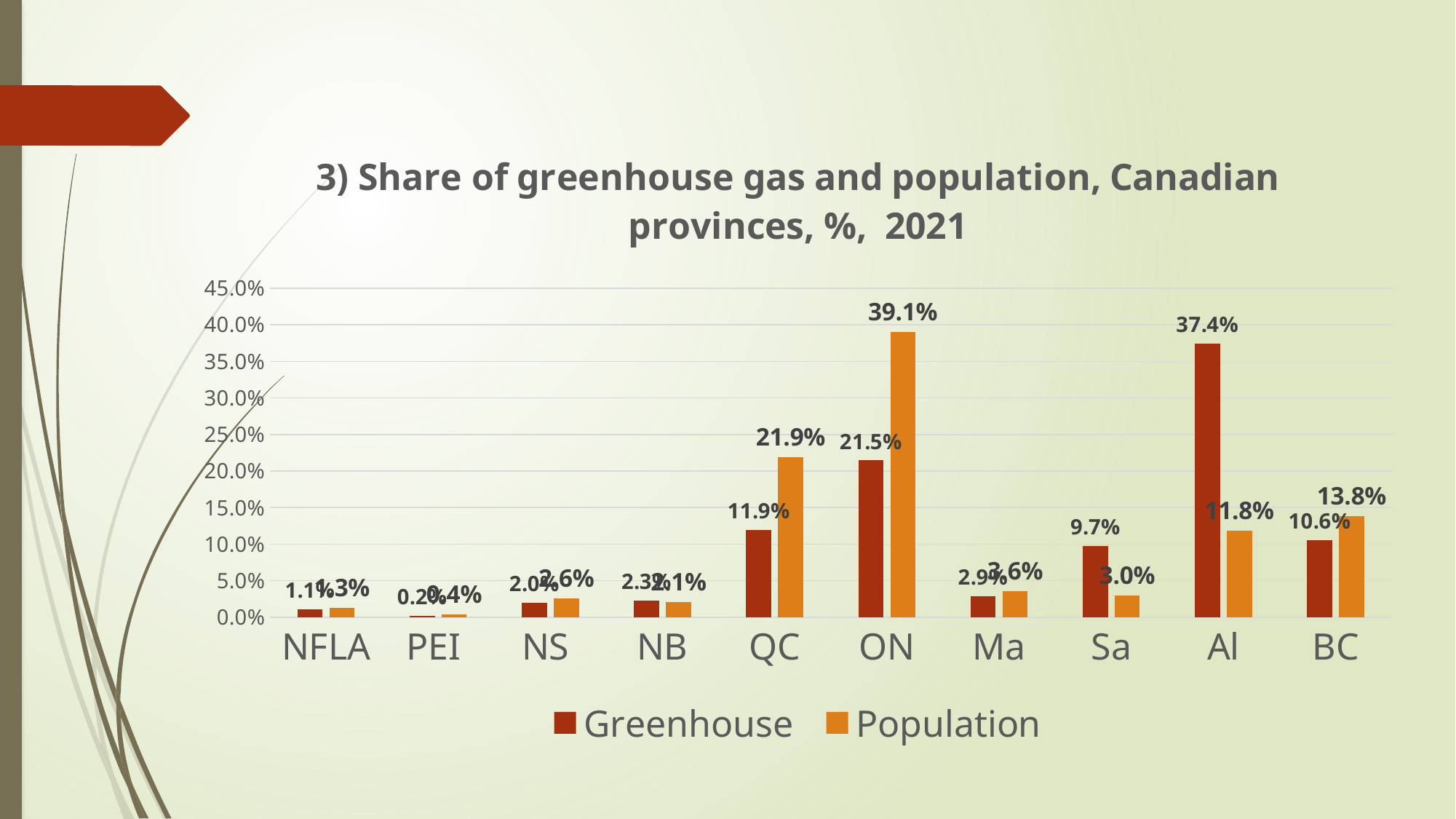
What is the Population value for BC? 13.8% Which province has the highest Greenhouse share? Al How many series does the legend list? 2 Which is larger for Sa, the Greenhouse value or the Population value? Greenhouse What is the Population value for ON? 39.1% What is the difference between the Population and Greenhouse values for ON? 17.6% Is the Population value for QC greater or less than 20.0%? greater How many provinces are shown on the x axis? 10 Which province has the highest Population share? ON What kind of chart is shown on the slide? bar chart What is the Greenhouse value for QC? 11.9% What is the Greenhouse value for Al? 37.4%